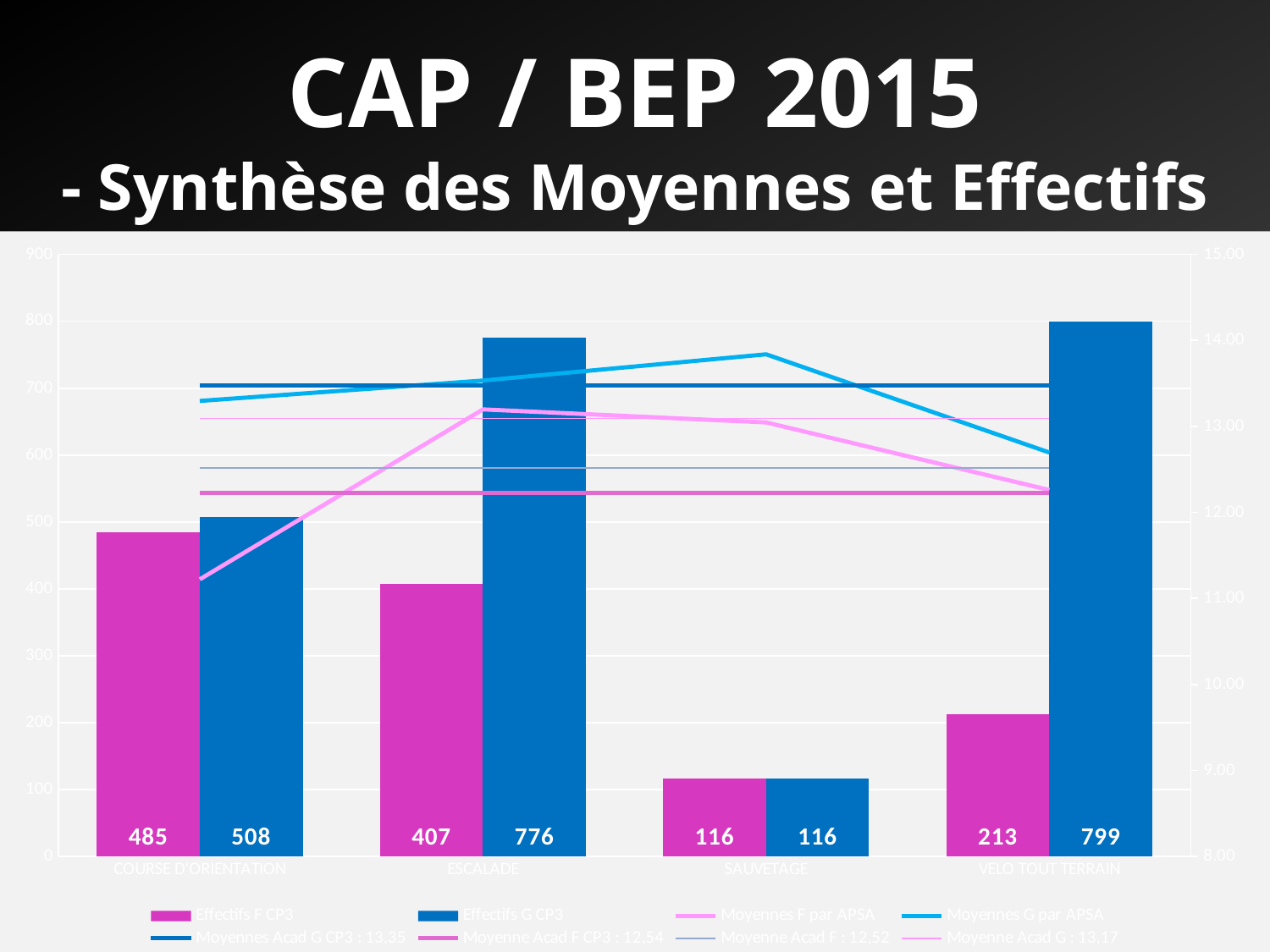
Which category has the highest Effectifs G CP3 value? Vélo tout terrain What is the difference between Effectifs G CP3 and Effectifs F CP3 for Escalade? 369 What is the value of Effectifs F CP3 for Escalade? 407 Is the Moyennes G par APSA value for Sauvetage greater or less than 13,00 on the right axis? greater How many series does the legend list? 8 What value does the legend give for Moyennes Acad G CP3? 13,35 What is the combined total of Effectifs F CP3 and Effectifs G CP3 for Sauvetage? 232 What is the value of Effectifs G CP3 for Vélo tout terrain? 799 Which category has the lowest Effectifs F CP3 value? Sauvetage How many categories are shown on the x axis? 4 What kind of chart is this? Combined bar and line chart For Course d'orientation, which is larger: Effectifs F CP3 or Effectifs G CP3? Effectifs G CP3